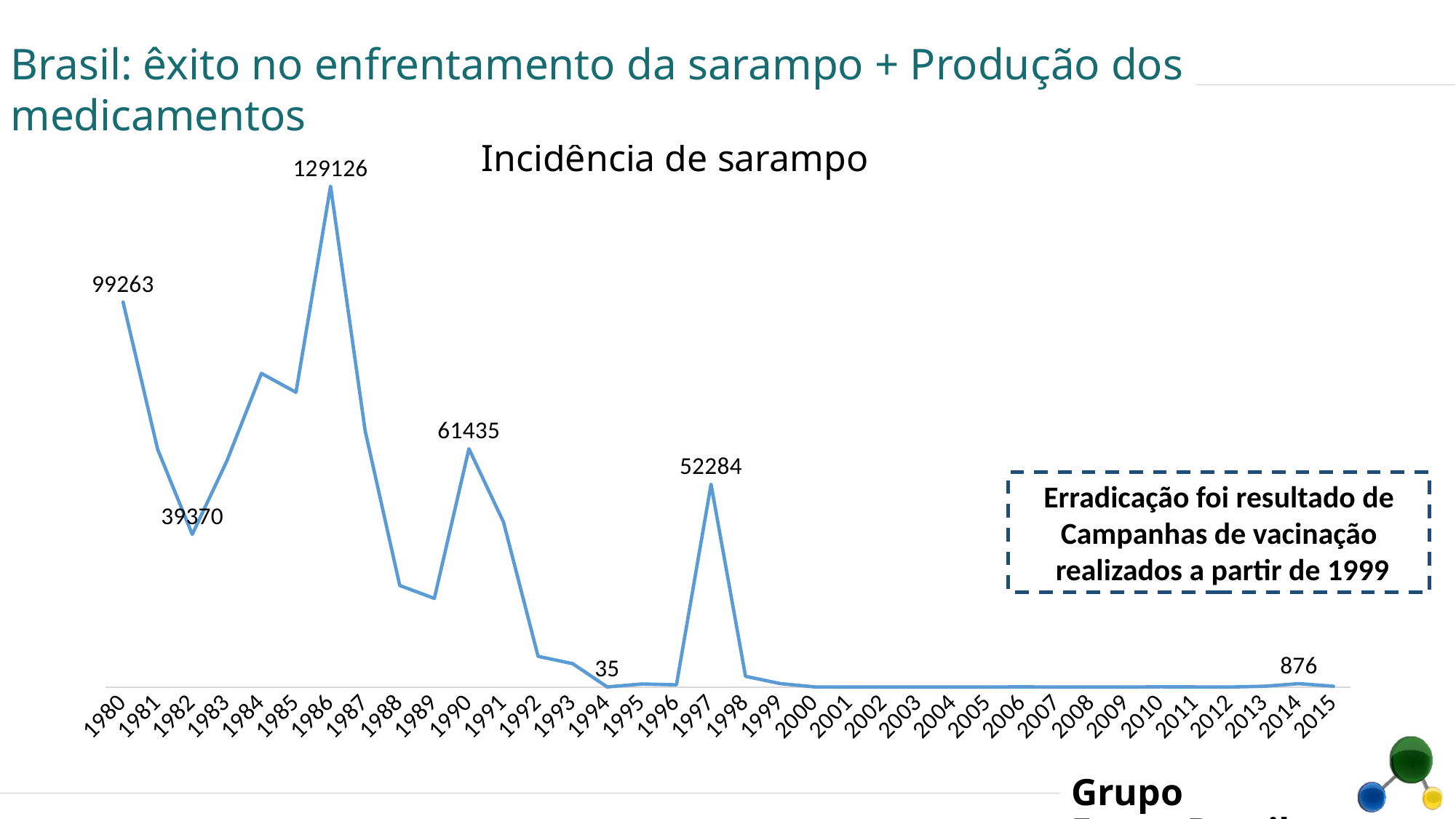
How many years are plotted on the x axis of the chart? 36 What is the title of the chart? Incidência de sarampo Which is larger, the value for 1990 or the value for 1997? 1990 What is the value for 1982 in the chart? 39370 Does the value generally rise or fall from 1997 to 2015? fall What is the value for 1980 in the chart? 99263 What type of chart is shown on the slide? line chart What is the value for 2014 in the chart? 876 What is the value for 1997 in the chart? 52284 What is the difference between the values for 1986 and 1980? 29863 Which year has the highest value in the chart? 1986 What is the value for 1986 in the chart? 129126